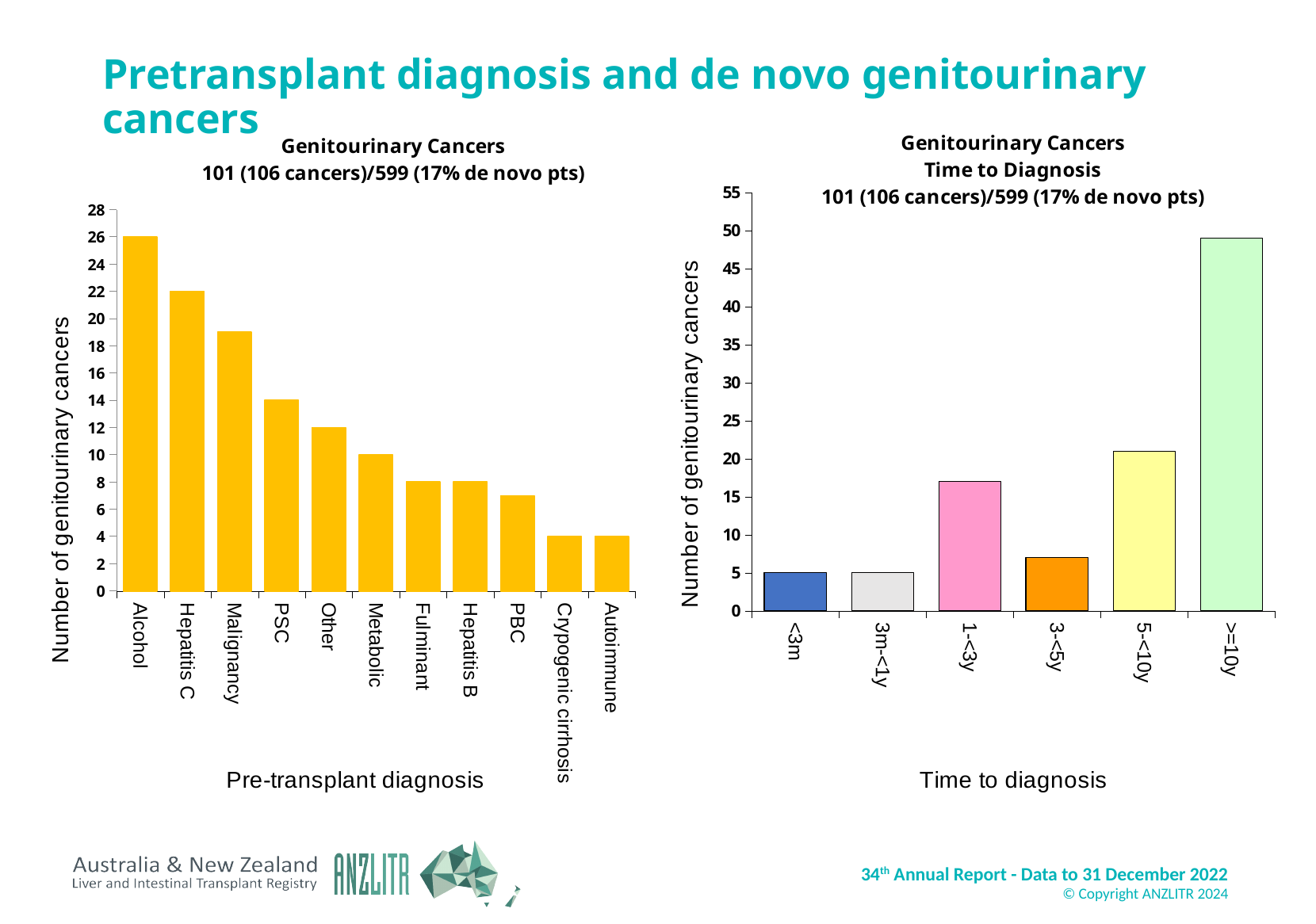
In the right chart (Genitourinary Cancers Time to Diagnosis), what is the value for <3m? 5 In the right chart (Genitourinary Cancers Time to Diagnosis), is the value for >=10y greater or less than 45? greater In the left chart (Genitourinary Cancers by pre-transplant diagnosis), which pre-transplant diagnosis has the highest number of genitourinary cancers? Alcohol In the left chart (Genitourinary Cancers by pre-transplant diagnosis), what is the number of genitourinary cancers for Alcohol? 26 In the left chart (Genitourinary Cancers by pre-transplant diagnosis), what is the value for PSC? 14 In the right chart (Genitourinary Cancers Time to Diagnosis), how many time-to-diagnosis categories are shown? 6 In the left chart (Genitourinary Cancers by pre-transplant diagnosis), what is the difference between the values for Alcohol and Hepatitis C? 4 In the left chart (Genitourinary Cancers by pre-transplant diagnosis), do the values rise or fall moving from left to right along the x axis? fall In the left chart (Genitourinary Cancers by pre-transplant diagnosis), what is the value for Hepatitis C? 22 In the left chart (Genitourinary Cancers by pre-transplant diagnosis), which is larger, the value for Other or the value for Metabolic? Other In the left chart (Genitourinary Cancers by pre-transplant diagnosis), how many pre-transplant diagnosis categories are shown? 11 In the right chart (Genitourinary Cancers Time to Diagnosis), which time-to-diagnosis category has the highest number of genitourinary cancers? >=10y